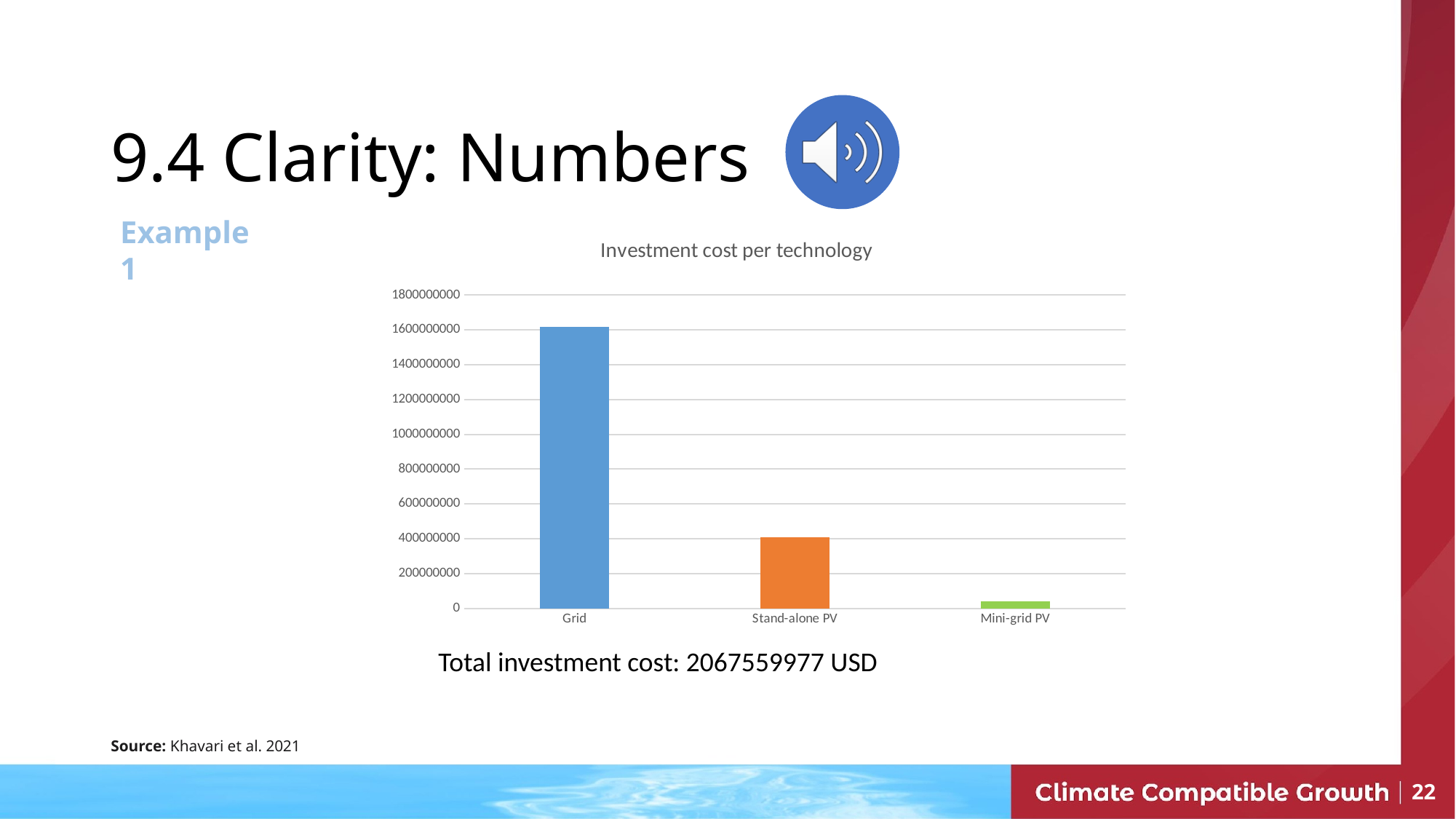
Which technology has the lowest investment cost in the chart? Mini-grid PV Do the bar values rise or fall moving from left to right along the x axis? fall Is the investment cost for Stand-alone PV greater or less than 600000000? less Which has a larger investment cost, Stand-alone PV or Mini-grid PV? Stand-alone PV Which has a larger investment cost, Grid or Stand-alone PV? Grid Which technology has the highest investment cost in the chart? Grid How many technologies (categories) are shown on the x axis of the chart? 3 What colour is the bar for Stand-alone PV? orange Is the investment cost for Grid greater or less than 1400000000? greater What kind of chart is shown on the slide? bar chart What is the title of the chart? Investment cost per technology Is the investment cost for Mini-grid PV greater or less than 200000000? less